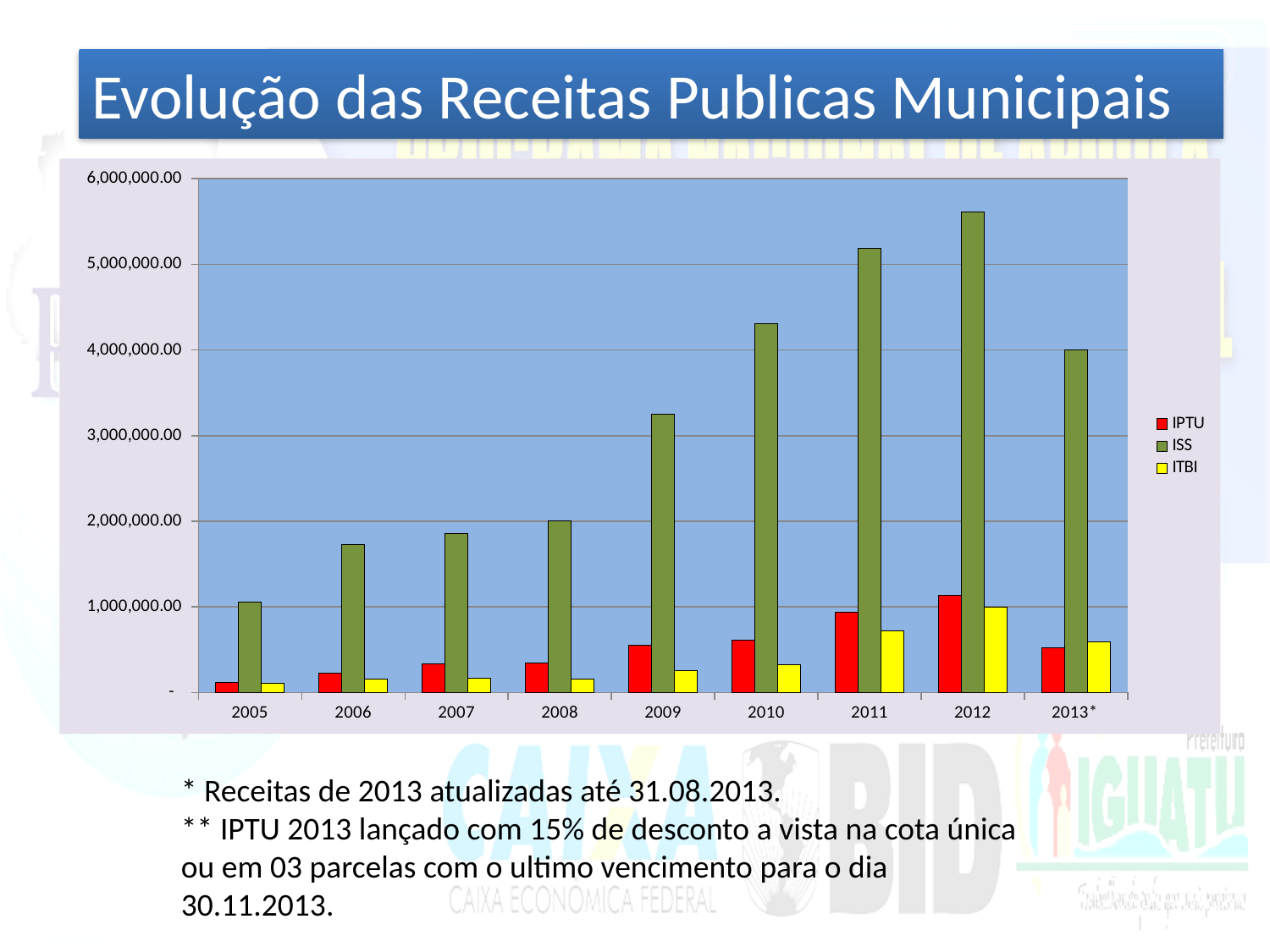
Which is larger in 2010, the ISS value or the IPTU value? ISS What kind of chart is shown on the slide? bar chart In which year is the IPTU value highest? 2012 Does the ISS value rise or fall from 2005 to 2012? rise Is the ISS value for 2011 greater or less than 5,000,000.00? greater How many years are shown on the x axis? 9 In which year is the ISS value lowest? 2005 What is the title of the chart? Evolução das Receitas Publicas Municipais Is the ISS value for 2009 greater or less than 3,000,000.00? greater In which year is the ISS value highest? 2012 How many series does the legend list? 3 Is the IPTU value for 2011 greater or less than 1,000,000.00? less